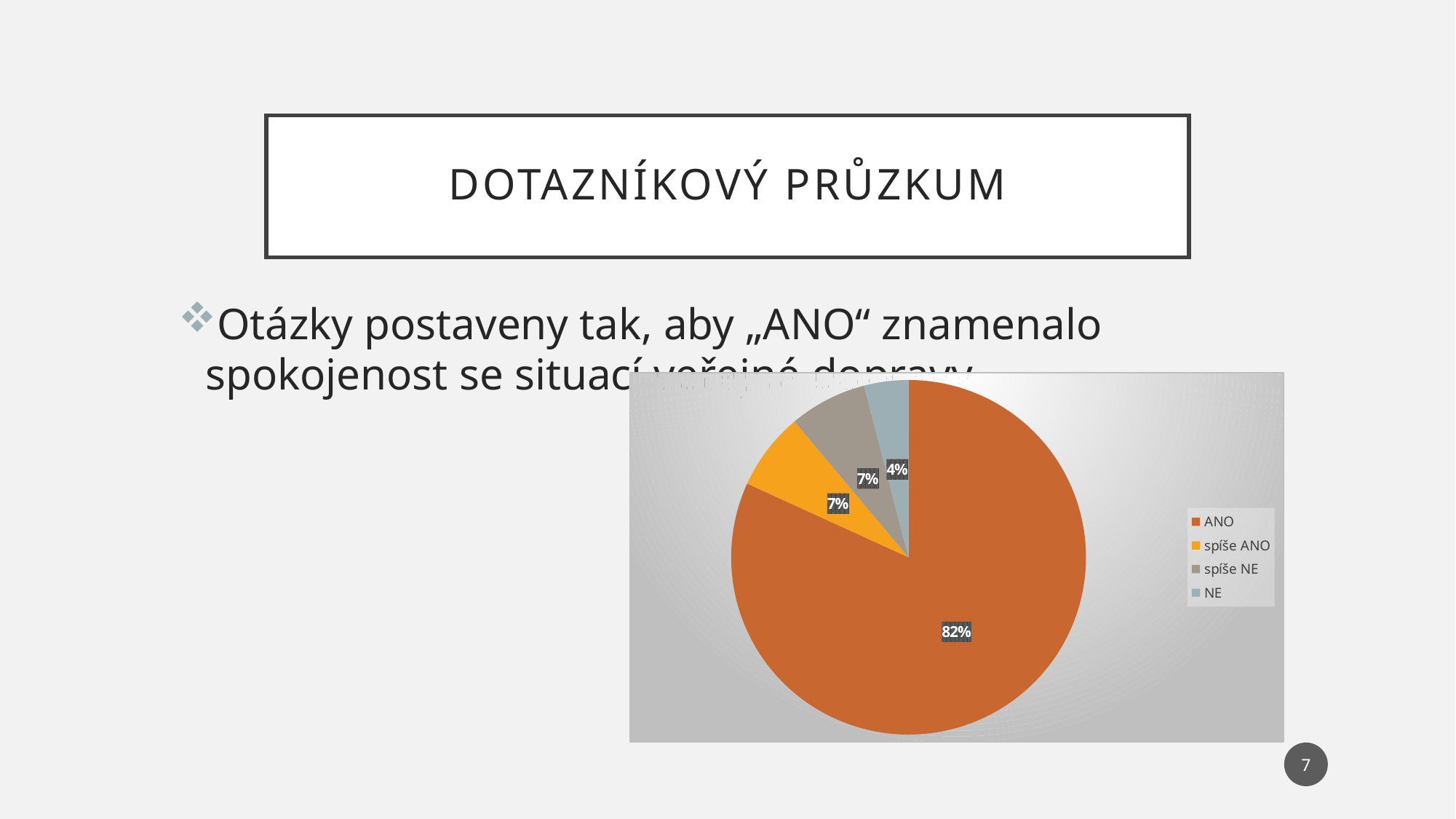
What is the value shown for the NE slice? 4% What share of the pie does the ANO slice represent? 82% How many categories does the legend list? 4 What colour is the ANO slice in the pie chart? orange Which legend entry is shown in yellow? spíše ANO What is the value shown for the spíše ANO slice? 7% Which category has the smallest slice of the pie? NE Which category has the largest slice of the pie? ANO Which is larger, the spíše ANO slice or the NE slice? spíše ANO What is the difference in percentage points between the ANO slice and the NE slice? 78 What is the value shown for the spíše NE slice? 7% What kind of chart is shown on the slide? pie chart